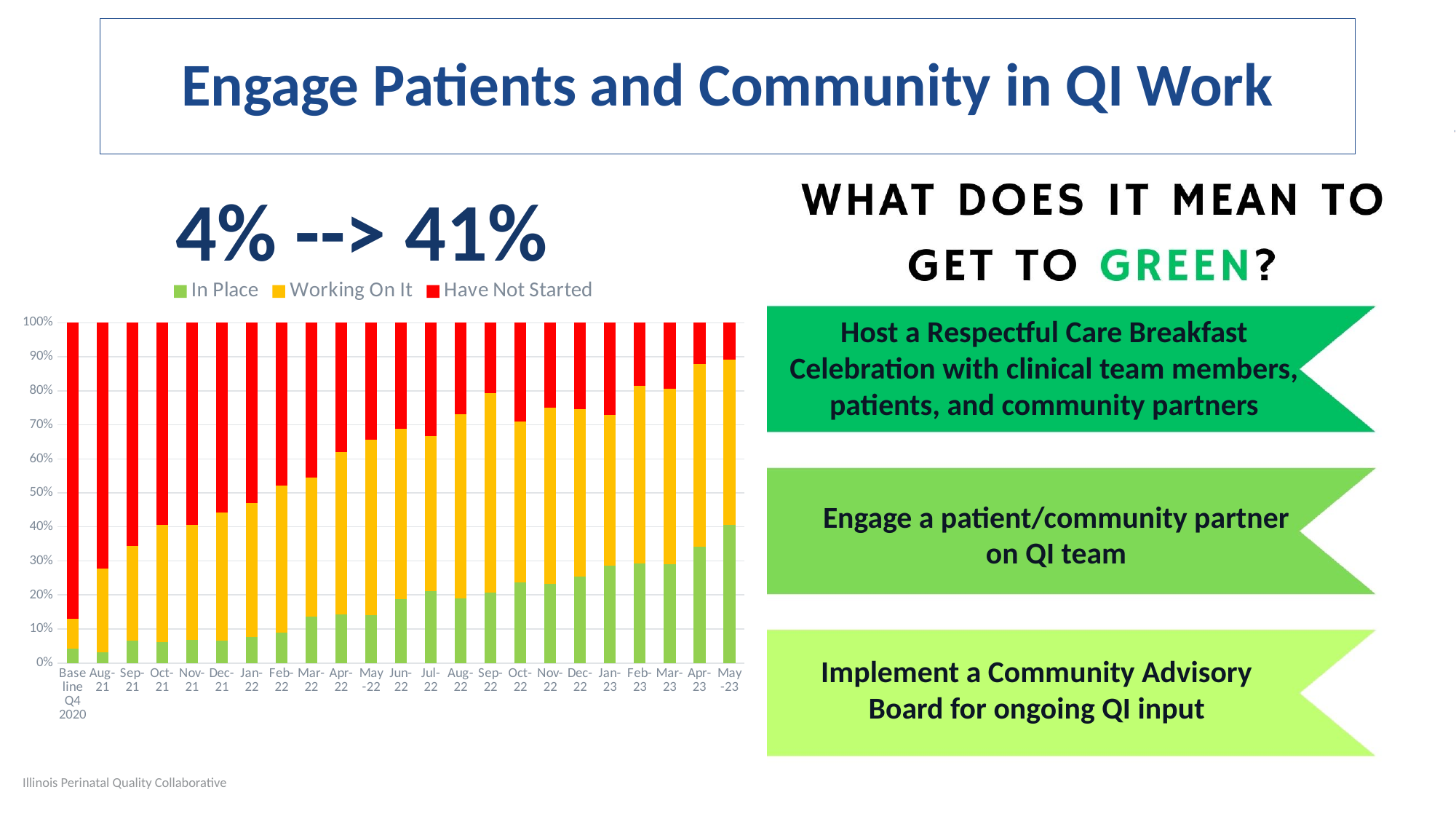
Which is larger, the Have Not Started value for Baseline Q4 2020 or for May-23? Baseline Q4 2020 How many time-period categories are plotted along the x axis of the chart? 23 Is the In Place value for May-23 greater or less than 30%? greater What does each stacked bar in the chart total to, as shown by the top of the bars on the y axis? 100% Is the Have Not Started value for Baseline Q4 2020 greater or less than 80%? greater What are the three series named in the chart legend? In Place, Working On It, Have Not Started Does the Have Not Started series rise or fall from Baseline Q4 2020 to May-23? Fall What kind of chart is shown on the slide? Stacked bar chart Does the In Place series rise or fall from Baseline Q4 2020 to May-23? Rise Which category has the highest In Place value in the chart? May-23 Which category has the lowest In Place value in the chart? Aug-21 How many series does the chart legend list? 3